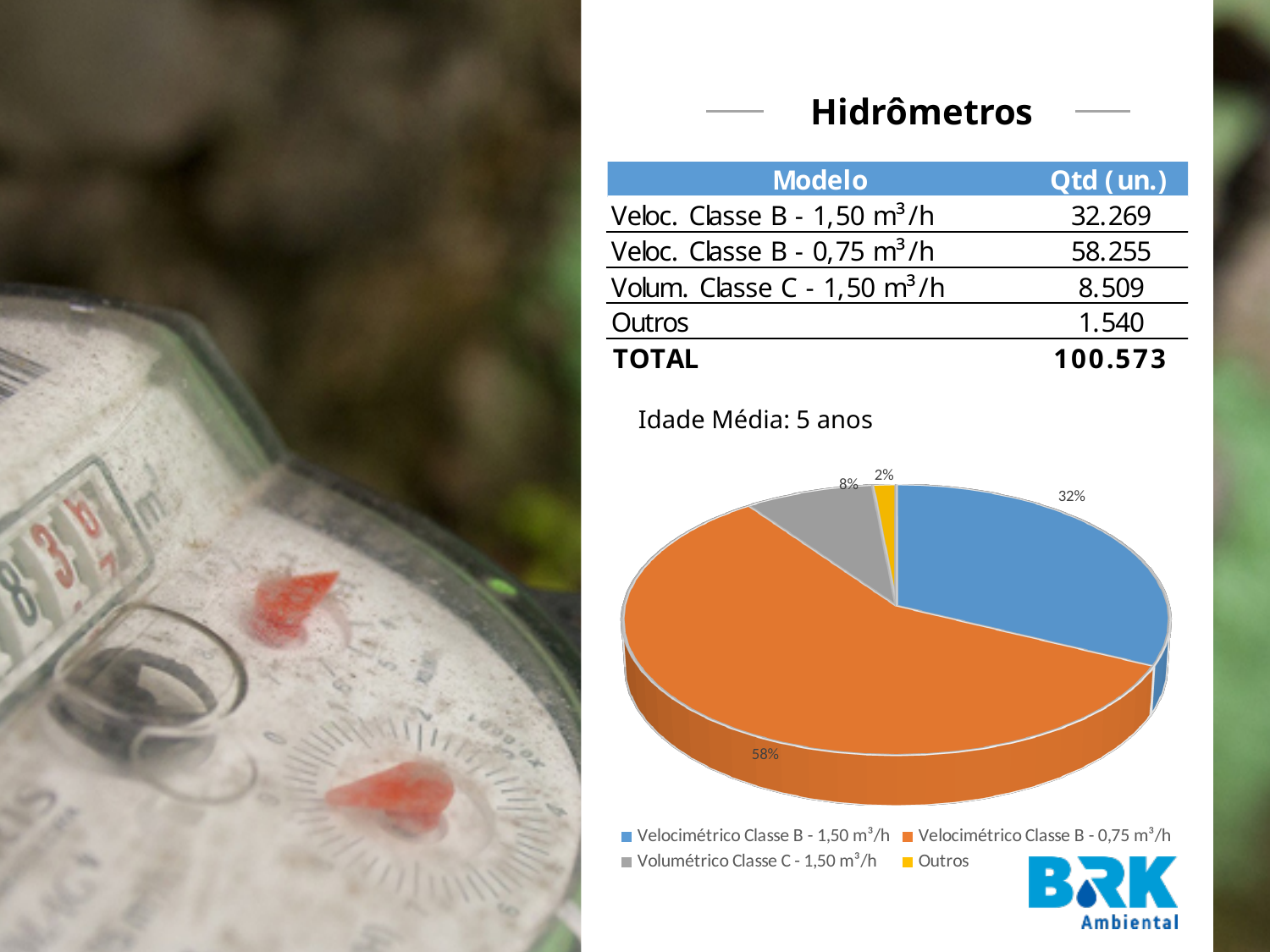
How many entries does the pie chart's legend list? 4 What share of the pie does Velocimétrico Classe B - 1,50 m³/h represent? 32% Which slice is larger, Volumétrico Classe C - 1,50 m³/h or Outros? Volumétrico Classe C - 1,50 m³/h Which category has the largest slice of the pie chart? Velocimétrico Classe B - 0,75 m³/h What share of the pie does Volumétrico Classe C - 1,50 m³/h represent? 8% What share of the pie does Velocimétrico Classe B - 0,75 m³/h represent? 58% How many slices does the pie chart have? 4 What colour is the slice for Velocimétrico Classe B - 1,50 m³/h in the pie chart? blue What is the difference in percentage points between the Velocimétrico Classe B - 0,75 m³/h slice and the Velocimétrico Classe B - 1,50 m³/h slice? 26 percentage points What kind of chart is shown on the slide? pie chart Which category has the smallest slice of the pie chart? Outros